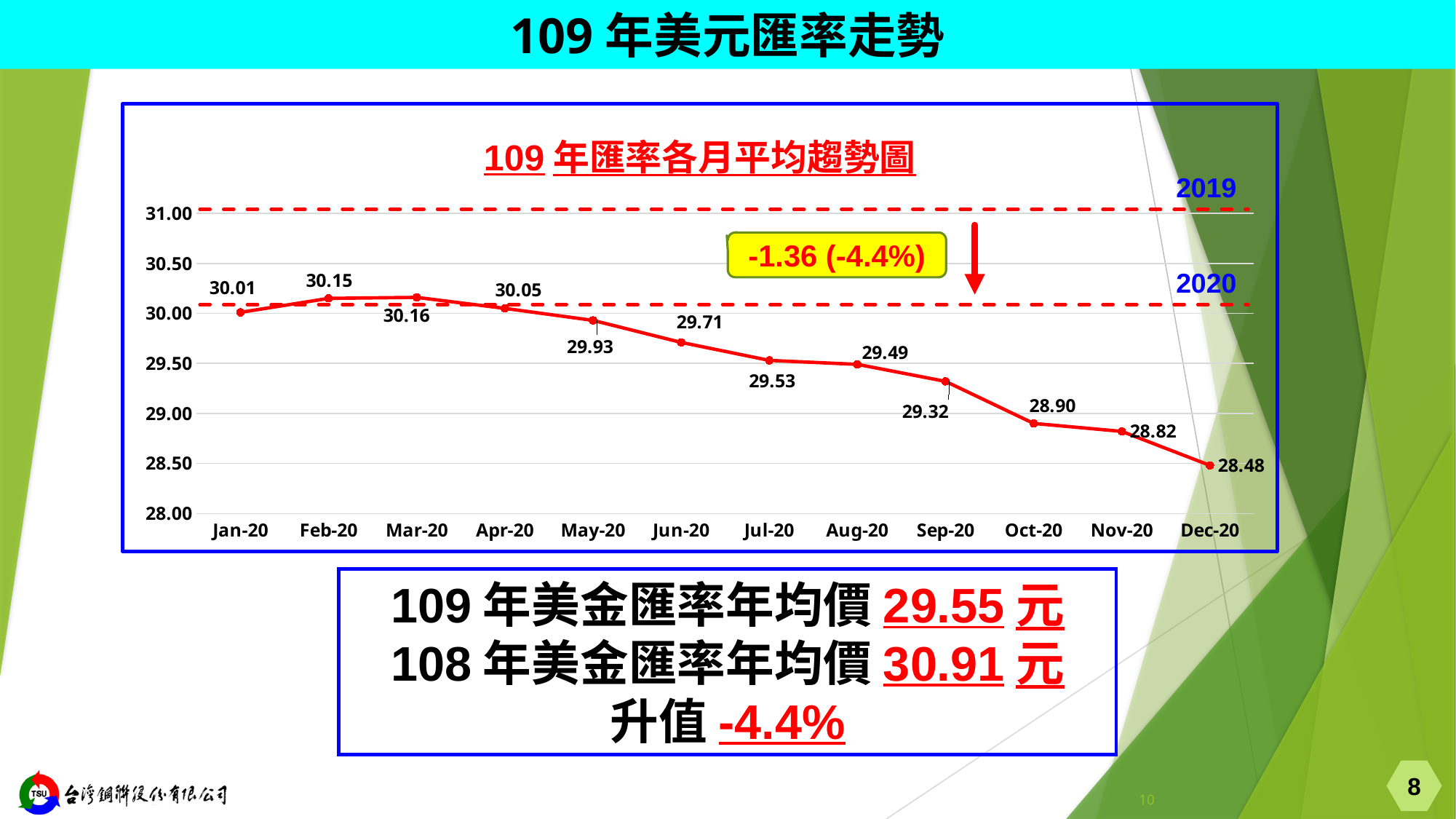
What is the difference between the Jan-20 value and the Dec-20 value? 1.53 What is the value for Sep-20? 29.32 What kind of chart is shown? line chart Which month has the highest value? Mar-20 How many months are plotted on the chart? 12 Which month has the lowest value? Dec-20 What change is shown in the yellow annotation box between the 2019 and 2020 dashed lines? -1.36 (-4.4%) What is the value for Dec-20? 28.48 Is the value for Nov-20 greater or less than 29.00? less Which is larger, the value for Jun-20 or the value for Oct-20? Jun-20 What is the value for Mar-20? 30.16 Do the values generally rise or fall from Jan-20 to Dec-20? fall